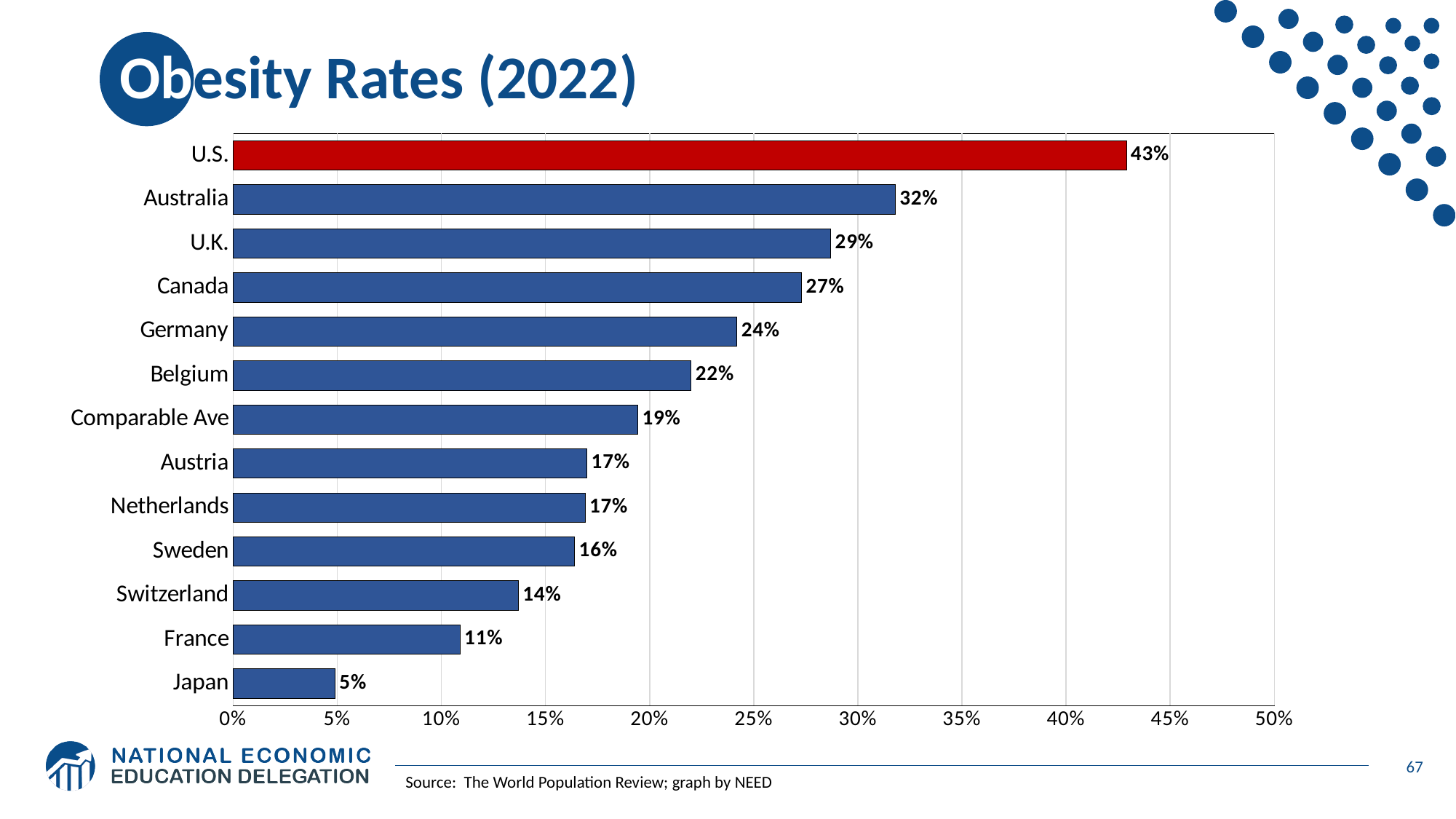
Which bar is coloured red rather than blue? U.S. Which country has the highest obesity rate on the chart? U.S. What is the difference between the obesity rates of Canada and France? 16% What is the difference between the obesity rates of the U.S. and Australia? 11% Which has a higher obesity rate, the U.K. or Belgium? U.K. How many categories are shown on the chart? 13 Is the value for Switzerland greater or less than 15%? less Which country has the lowest obesity rate on the chart? Japan What is the obesity rate shown for Germany? 24% What is the obesity rate shown for the U.S.? 43% What kind of chart is shown on the slide? Bar chart What is the value shown for Comparable Ave? 19%